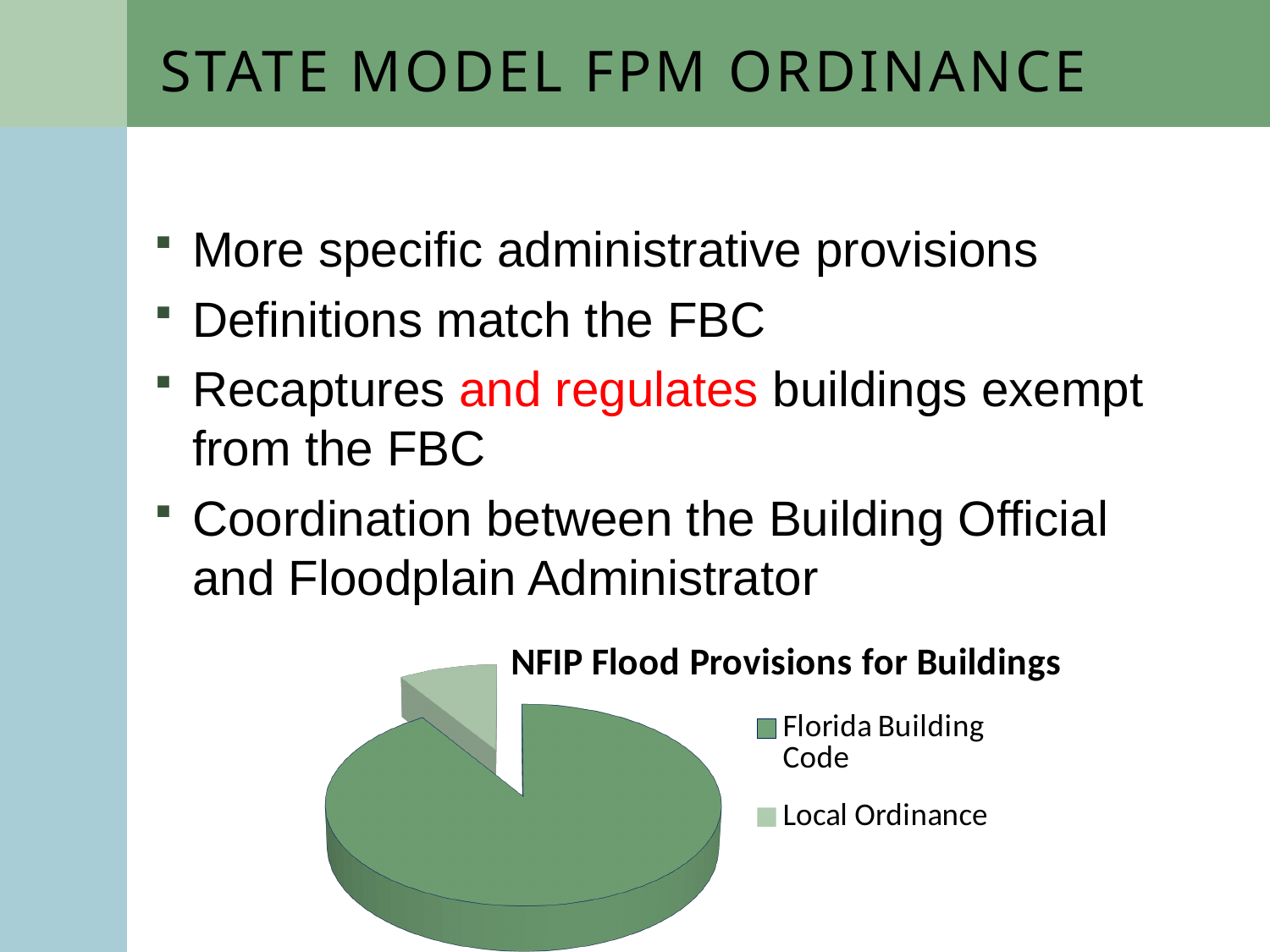
How many entries does the pie chart's legend list? 2 Which slice is larger, Florida Building Code or Local Ordinance? Florida Building Code Which category has the largest slice of the pie chart? Florida Building Code Which category has the smallest slice of the pie chart? Local Ordinance How many slices does the pie chart have? 2 What is the title of the pie chart? NFIP Flood Provisions for Buildings What kind of chart is shown on the slide? Pie chart Which slice of the pie chart is pulled out (exploded) from the rest of the pie? Local Ordinance